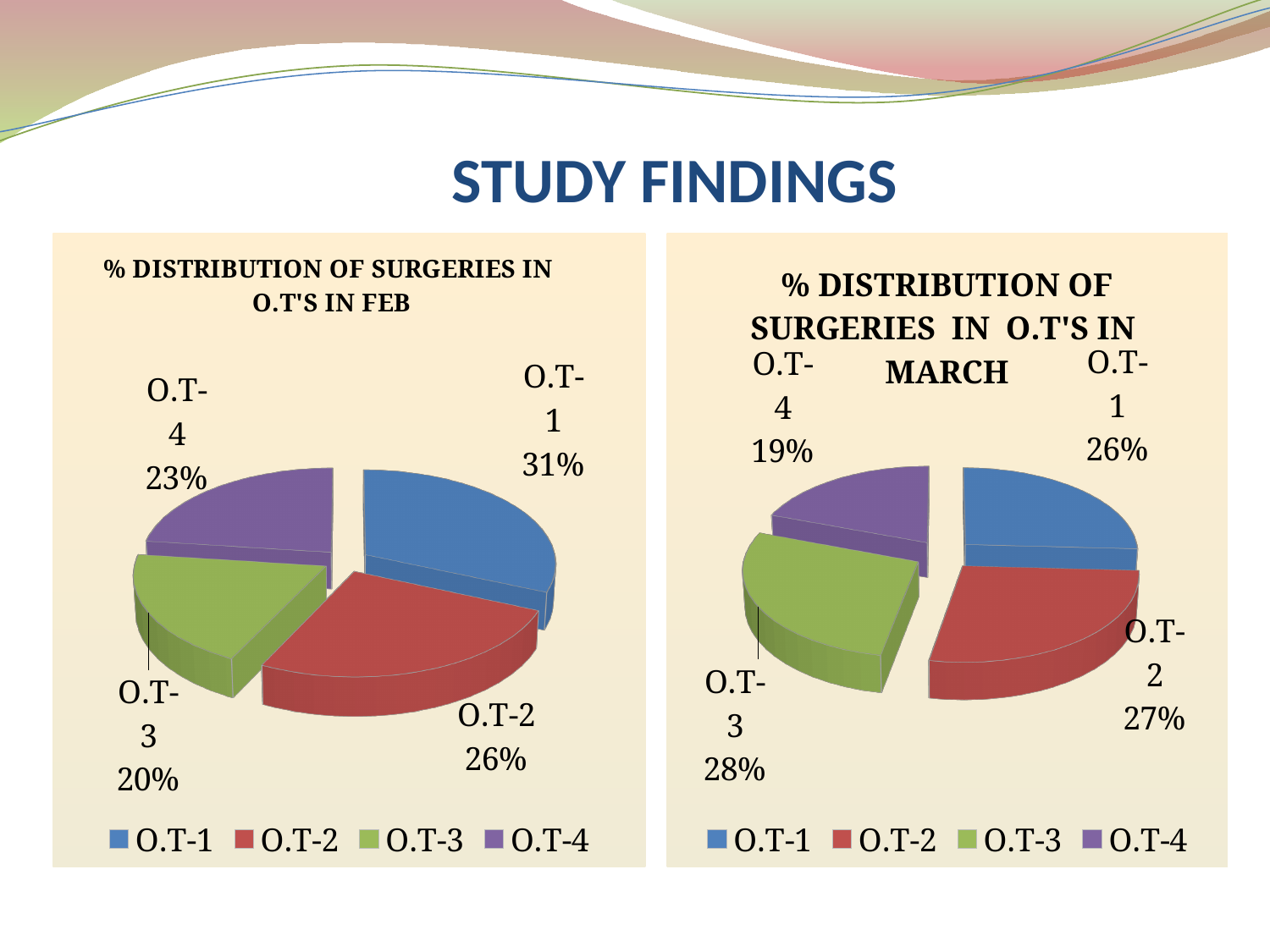
What is the title of the chart on the left? % DISTRIBUTION OF SURGERIES IN O.T'S IN FEB In the MARCH chart, what is the difference in percentage points between O.T-3 and O.T-4? 9 In the FEB chart, which O.T has the largest share of surgeries? O.T-1 In the MARCH chart, which is larger, the share for O.T-2 or O.T-1? O.T-2 What type of chart is used in the MARCH chart? Pie chart In the FEB chart, what is the difference in percentage points between O.T-1 and O.T-2? 5 In the MARCH chart, what percentage of surgeries were in O.T-3? 28% In the FEB chart, which O.T has the smallest share of surgeries? O.T-3 How many slices does the FEB pie chart have? 4 In the FEB chart, what percentage of surgeries were in O.T-1? 31% In the MARCH chart, which O.T has the smallest share of surgeries? O.T-4 How many entries does the legend of the FEB chart list? 4